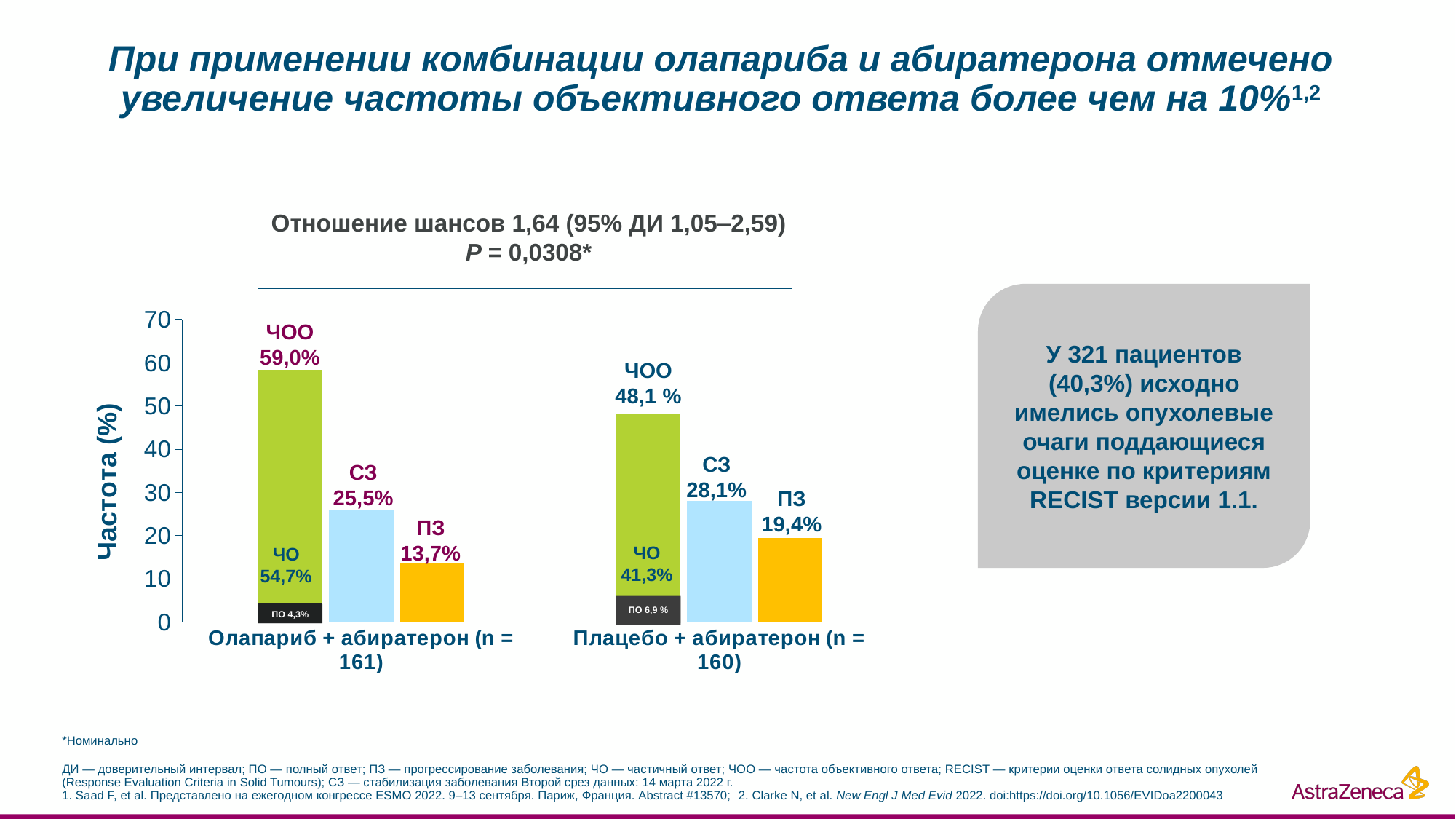
What is the ЧОО value for the Плацебо + абиратерон (n = 160) group? 48,1 % What is the СЗ value for the Олапариб + абиратерон (n = 161) group? 25,5% What is the difference in ЧОО between the Олапариб + абиратерон group and the Плацебо + абиратерон group? 10,9% What type of chart is shown on the slide? Bar chart Which outcome has the lowest value in the Олапариб + абиратерон (n = 161) group: ЧОО, СЗ or ПЗ? ПЗ Which group has the higher ЧОО value, Олапариб + абиратерон or Плацебо + абиратерон? Олапариб + абиратерон What is the ПО value for the Олапариб + абиратерон (n = 161) group? 4,3% What is the label of the vertical axis of the chart? Частота (%) What is the difference in ПЗ between the Плацебо + абиратерон group and the Олапариб + абиратерон group? 5,7% What is the ЧОО value for the Олапариб + абиратерон (n = 161) group? 59,0% What is the ПЗ value for the Плацебо + абиратерон (n = 160) group? 19,4% What is the ЧО value for the Плацебо + абиратерон (n = 160) group? 41,3%